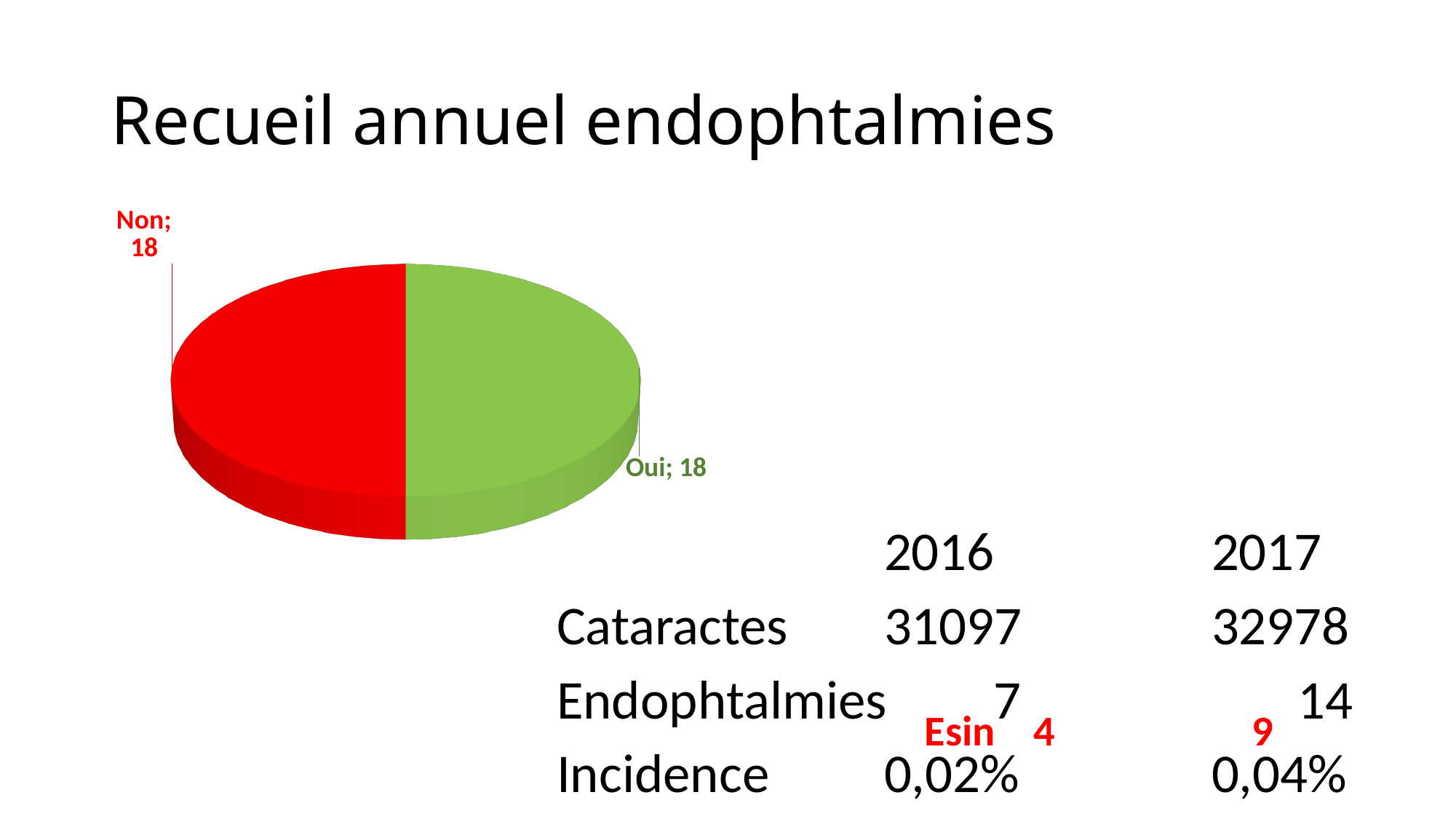
What share of the pie chart does the "Non" slice represent? 50% What is the value of the "Oui" slice in the pie chart? 18 What is the value of the "Non" slice in the pie chart? 18 What is the total of all slices in the pie chart? 36 What share of the pie chart does the "Oui" slice represent? 50% How many slices does the pie chart have? 2 What colour is the "Oui" slice in the pie chart? green What is the difference between the "Non" and "Oui" values in the pie chart? 0 What kind of chart is shown on the slide? pie chart What colour is the "Non" slice in the pie chart? red